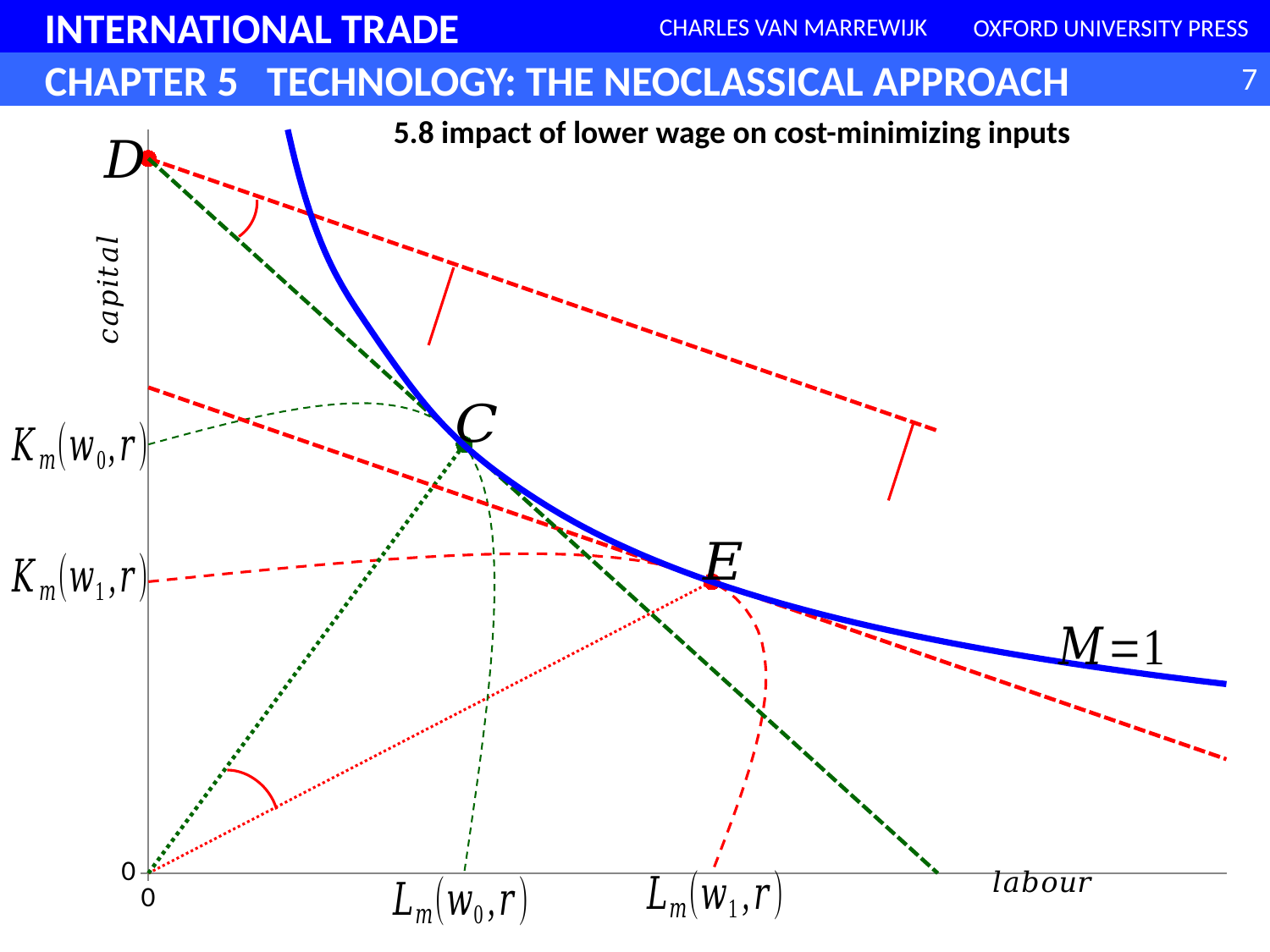
How many labelled points (marked with letters) are shown on the chart? 3 Which point, C or E, lies further along the labour axis? E What is the label written next to the solid blue curve? M=1 Which labelled point on the chart has the highest capital value? D Does the solid blue curve rise or fall as labour increases along the x axis? fall What kind of chart is shown on the slide? line chart Which point, C or E, lies higher on the capital axis? C What label is written on the vertical axis of the chart? capital Which capital level is higher on the vertical axis, Km(w0,r) or Km(w1,r)? Km(w0,r) What is the title of the chart on the slide? 5.8 impact of lower wage on cost-minimizing inputs Which labelled point on the chart has the lowest labour value? D